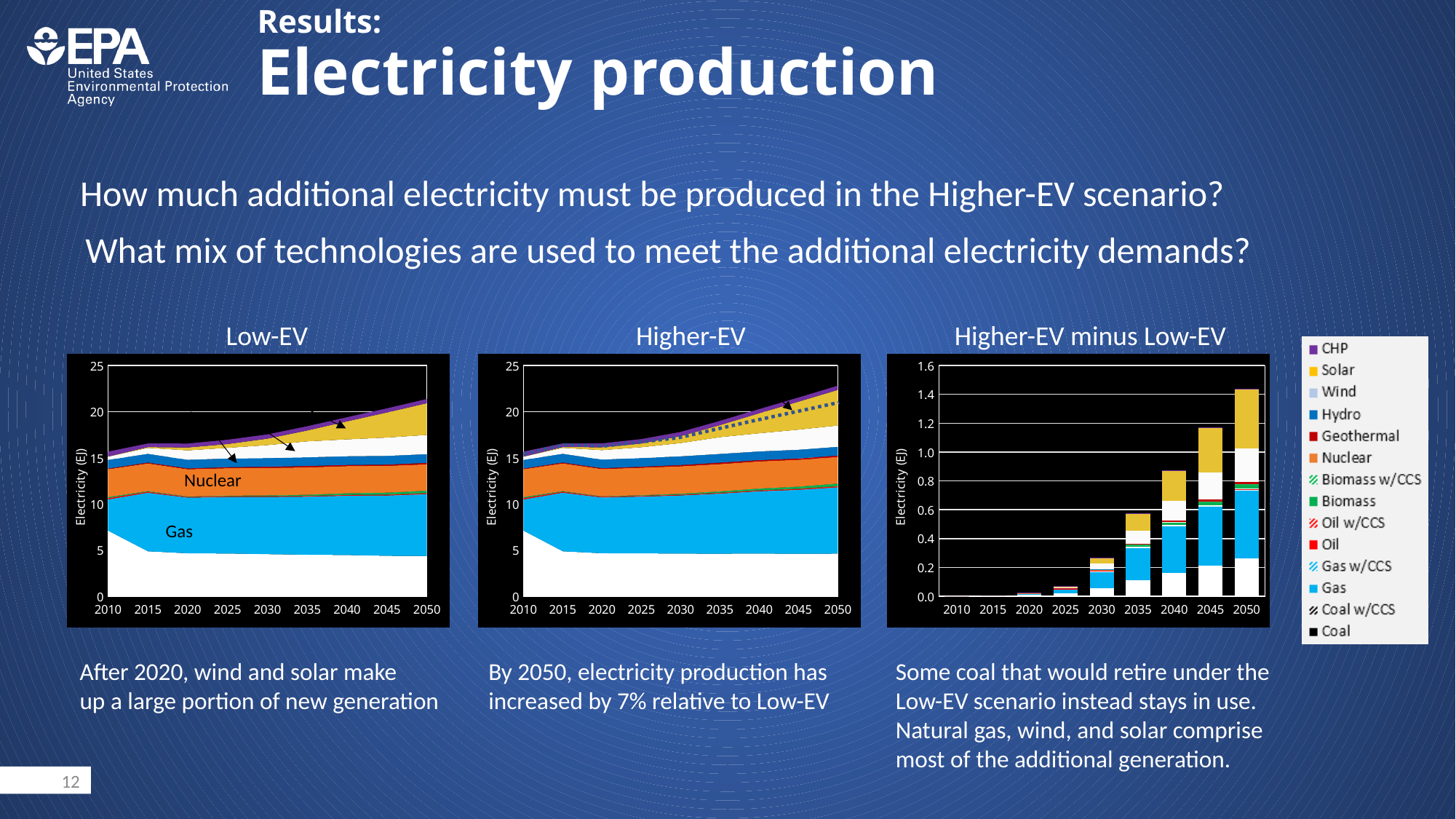
In the 'Higher-EV' chart, is the total electricity in 2010 greater or less than 20? less What kind of chart is the 'Higher-EV minus Low-EV' chart? Bar chart In the 'Higher-EV minus Low-EV' chart, which year has the tallest bar? 2050 In the 'Higher-EV minus Low-EV' chart, is the total for 2040 greater or less than 1.0? less What is the y-axis label on the 'Low-EV' chart? Electricity (EJ) In the 'Higher-EV minus Low-EV' chart, do the bar totals rise or fall from 2020 to 2050? Rise In the 'Higher-EV minus Low-EV' chart, is the total for 2030 greater or less than 0.4? less In the 'Higher-EV minus Low-EV' chart, how many years are labelled on the x axis? 9 What kind of chart is the 'Low-EV' chart? Stacked area chart How many series does the legend on the right of the slide list? 14